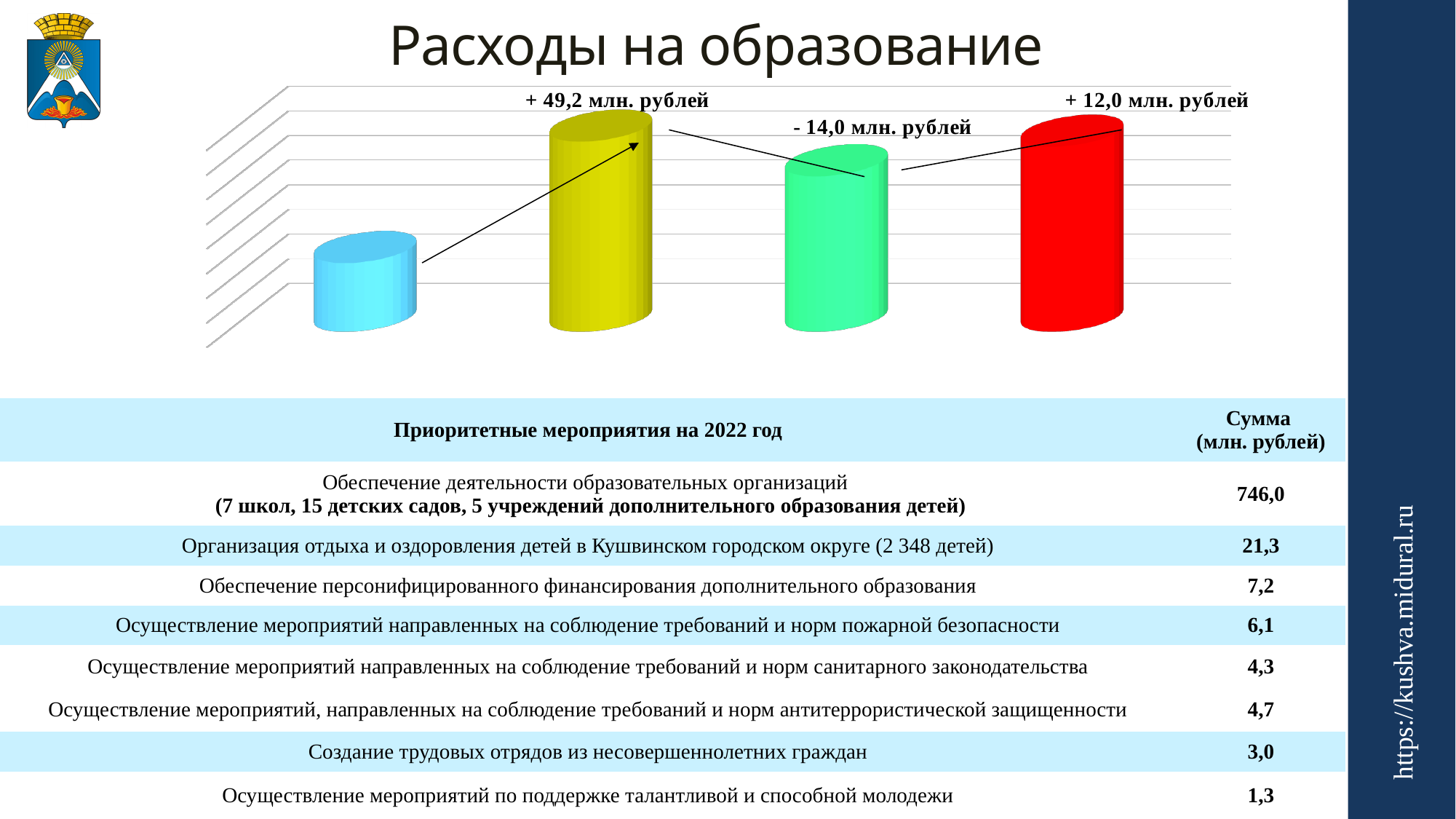
What change is labelled between the third and fourth bars of the chart? + 12,0 млн. рублей How many bars does the chart contain? 4 Which is larger, the third (green) bar or the fourth (red) bar? the fourth (red) bar What colour is the third bar in the chart? green Which is larger, the first (blue) bar or the second (yellow) bar? the second (yellow) bar Which bar in the chart is the lowest? the first (blue) bar What change is labelled between the second and third bars of the chart? - 14,0 млн. рублей What kind of chart is shown on the slide? bar chart Which is larger, the second (yellow) bar or the third (green) bar? the second (yellow) bar Does the value rise or fall from the second bar to the third bar? fall What is the title of the slide containing the chart? Расходы на образование What change is labelled between the first and second bars of the chart? + 49,2 млн. рублей